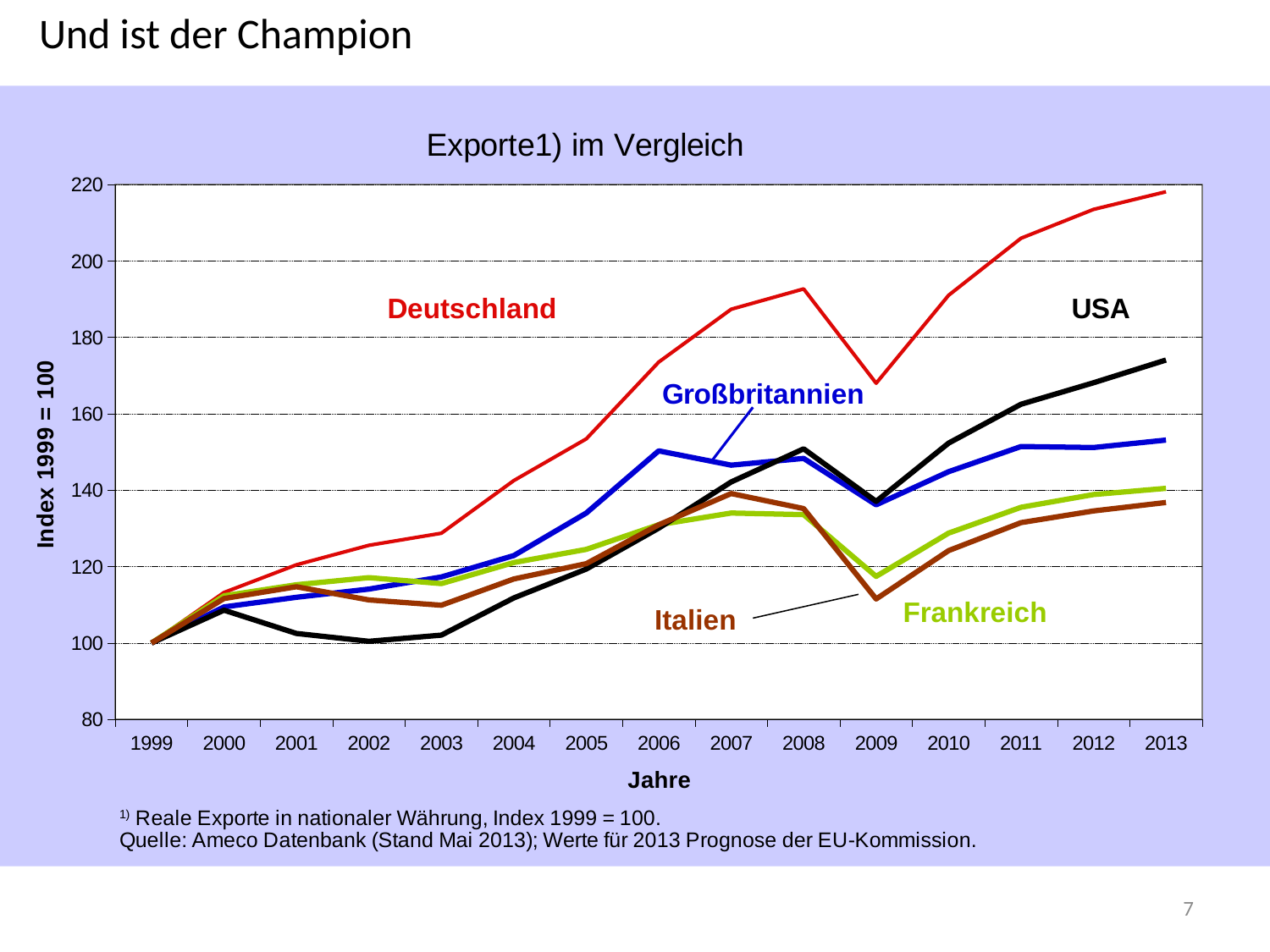
What is the index value for Deutschland in 1999? 100 How many years are shown along the x axis of the chart? 15 Is the value for Italien in 2009 greater or less than 120? less What kind of chart is shown on the slide? line chart Which country has the lowest index value in 2002? USA What is the label of the y axis of the chart? Index 1999 = 100 How many countries (series) are plotted in the chart? 5 Which country has the highest index value in 2013? Deutschland Is the value for Deutschland in 2013 greater or less than 200? greater Is the value for Großbritannien in 2013 greater or less than 160? less In 2008, which is larger: the value for Deutschland or the value for USA? Deutschland Does the Deutschland line rise or fall from 2009 to 2013? rise